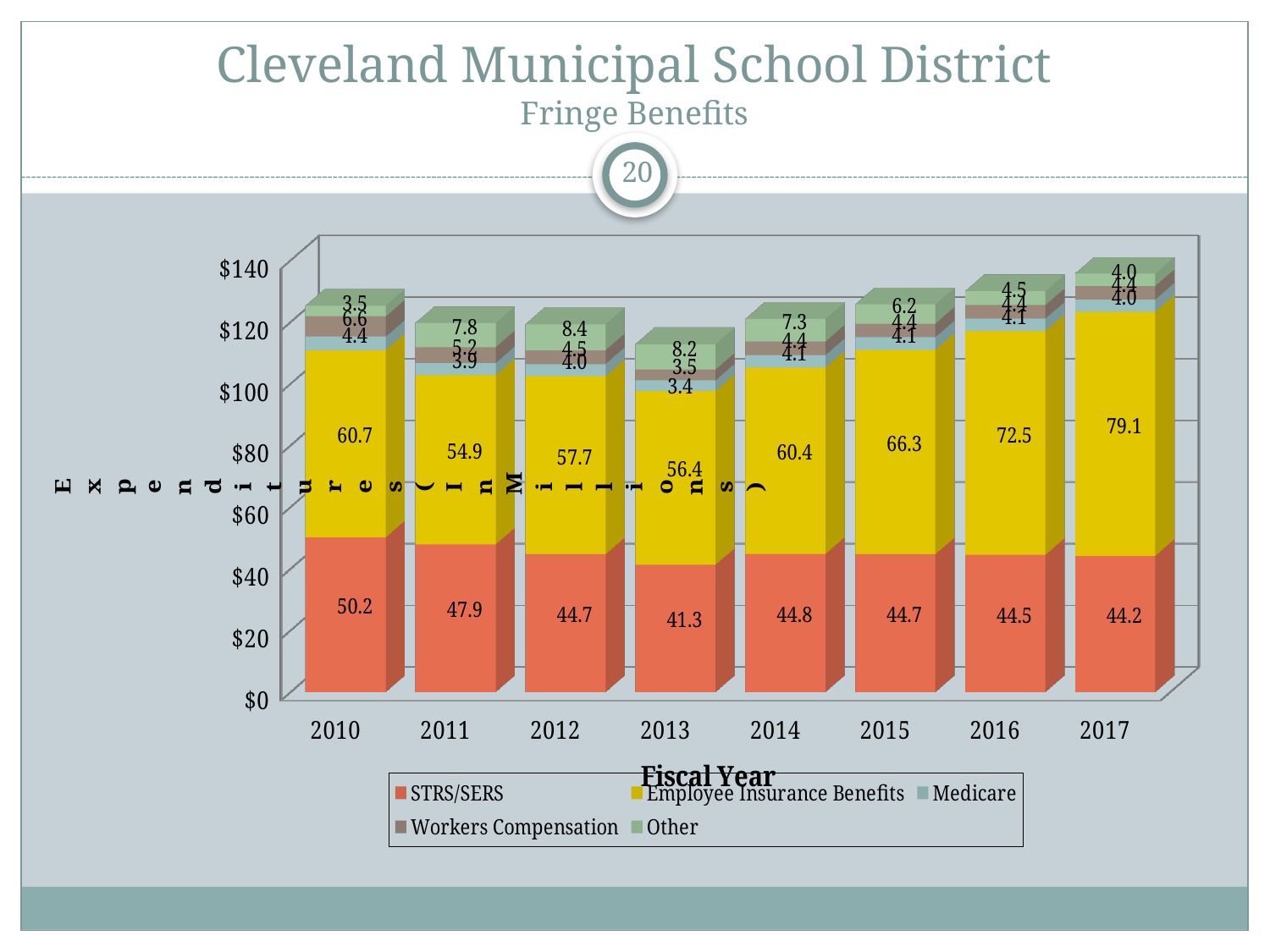
What is the Other value for fiscal year 2012? 8.4 How many series does the chart's legend list? 5 What is the Employee Insurance Benefits value for fiscal year 2017? 79.1 What is the STRS/SERS value for fiscal year 2010? 50.2 Do the Employee Insurance Benefits values rise or fall from 2013 to 2017? Rise Which fiscal year has the larger STRS/SERS value, 2011 or 2012? 2011 In which fiscal year is the Employee Insurance Benefits value highest? 2017 What is the difference between the Employee Insurance Benefits values for 2017 and 2010? 18.4 How many fiscal years are shown on the x axis of the chart? 8 What kind of chart is shown on the slide? Stacked bar chart In which fiscal year is the STRS/SERS value lowest? 2013 Is the total height of the 2013 stacked bar greater or less than $120? less